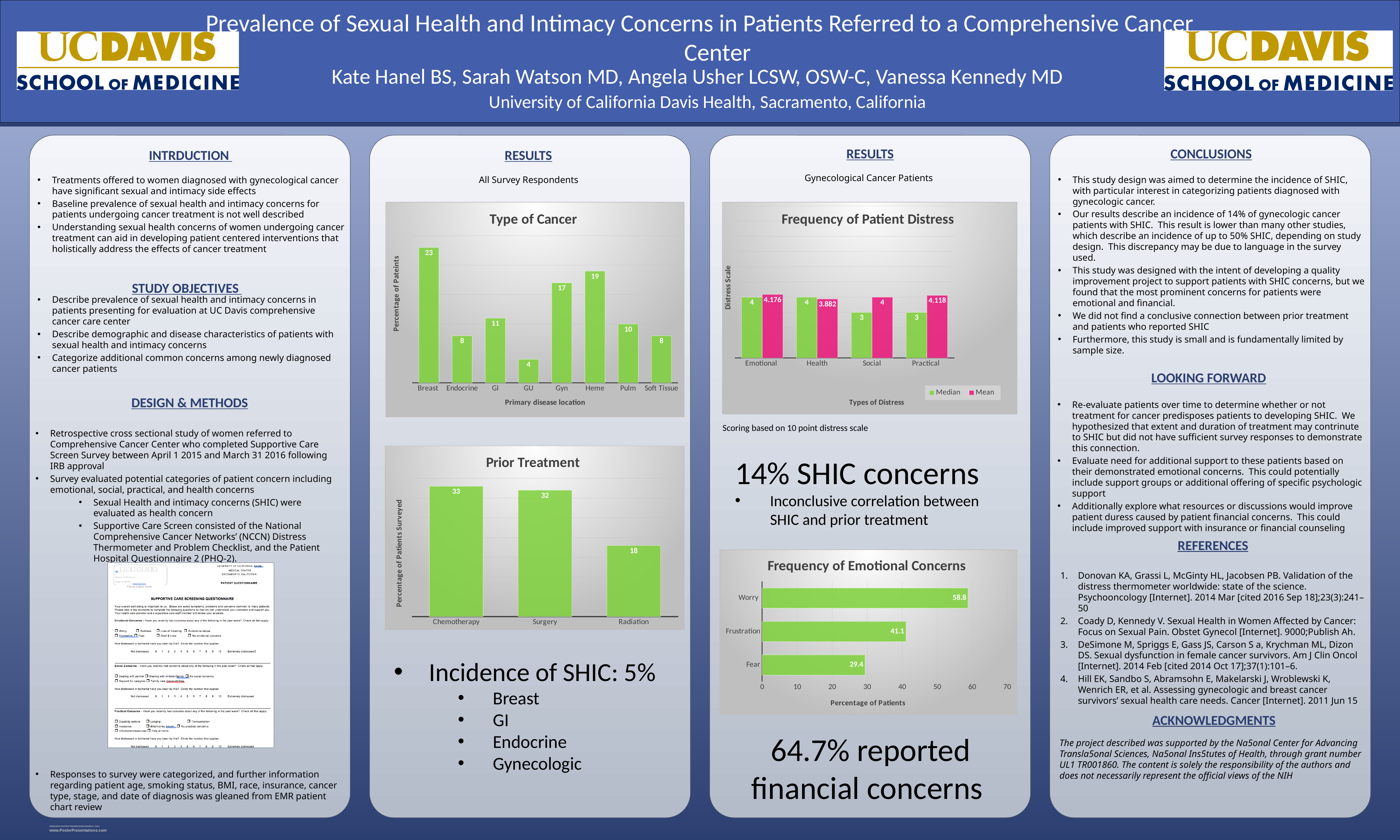
In the "Prior Treatment" chart, what is the value for Radiation? 18 In the "Frequency of Emotional Concerns" chart, what is the difference between the values for Worry and Fear? 29.4 How many series does the legend of the "Frequency of Patient Distress" chart list? 2 In the "Frequency of Patient Distress" chart, which is larger for Social: the Median or the Mean? Mean In the "Frequency of Emotional Concerns" chart, what is the value for Frustration? 41.1 In the "Prior Treatment" chart, which treatment has the highest value? Chemotherapy In the "Type of Cancer" chart, what is the value for Breast? 23 What kind of chart is the "Prior Treatment" chart? Bar chart In the "Frequency of Patient Distress" chart, what is the Mean value for Health? 3.882 In the "Type of Cancer" chart, what is the difference between the values for Heme and Gyn? 2 In the "Type of Cancer" chart, which primary disease location has the lowest value? GU How many primary disease locations are shown in the "Type of Cancer" chart? 8